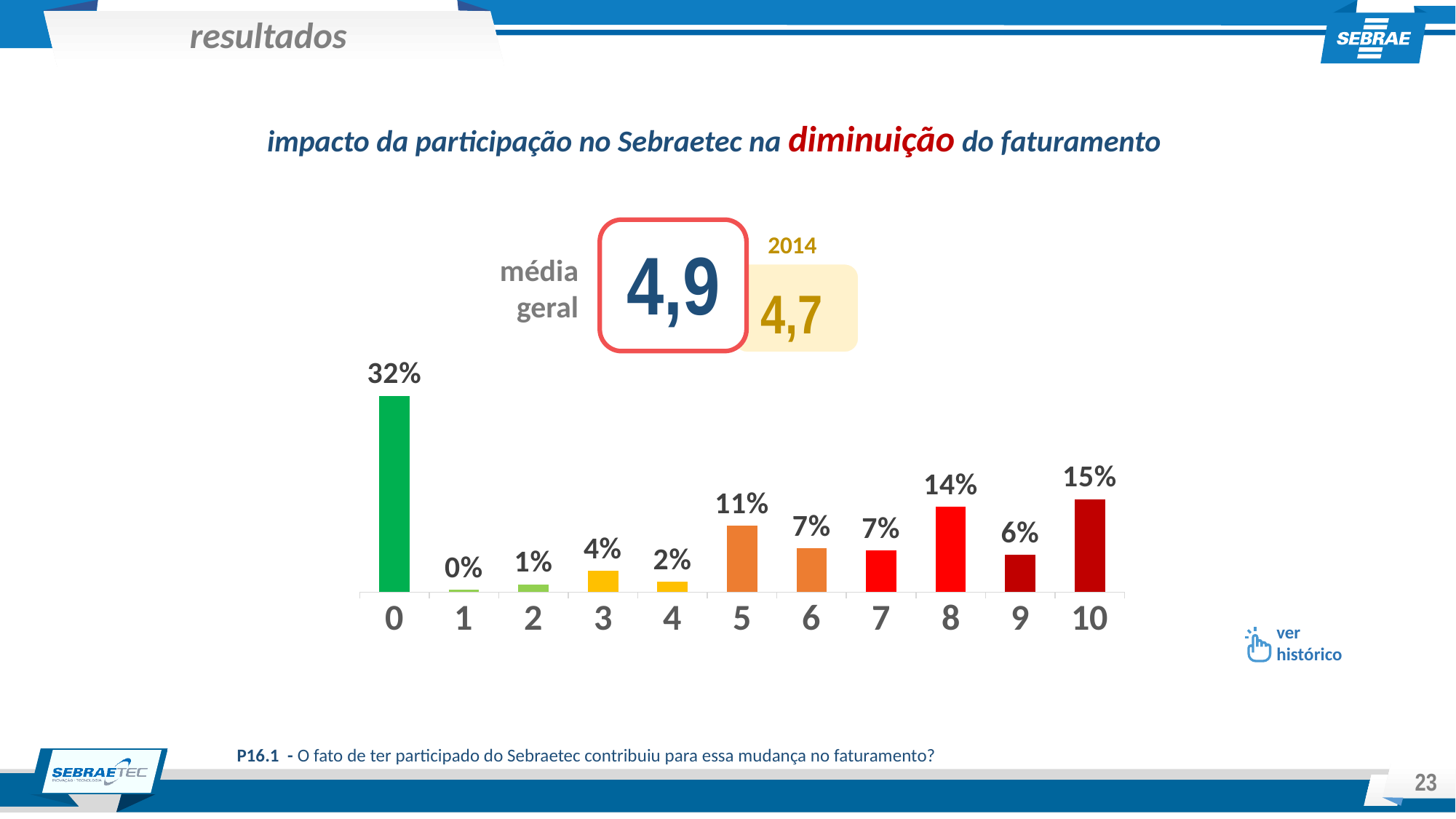
What is the difference between the percentages for category 0 and category 10? 17% Which category has the lowest percentage? 1 What percentage is shown for category 0? 32% What was the 2014 average value shown next to the 'média geral'? 4,7 How many categories are shown on the x axis? 11 What percentage is shown for category 10? 15% What percentage is shown for category 5? 11% Which category has the highest percentage? 0 What percentage is shown for category 8? 14% What kind of chart is shown on the slide? bar chart Which is larger, the percentage for category 8 or for category 9? 8 What is the 'média geral' value shown above the chart? 4,9